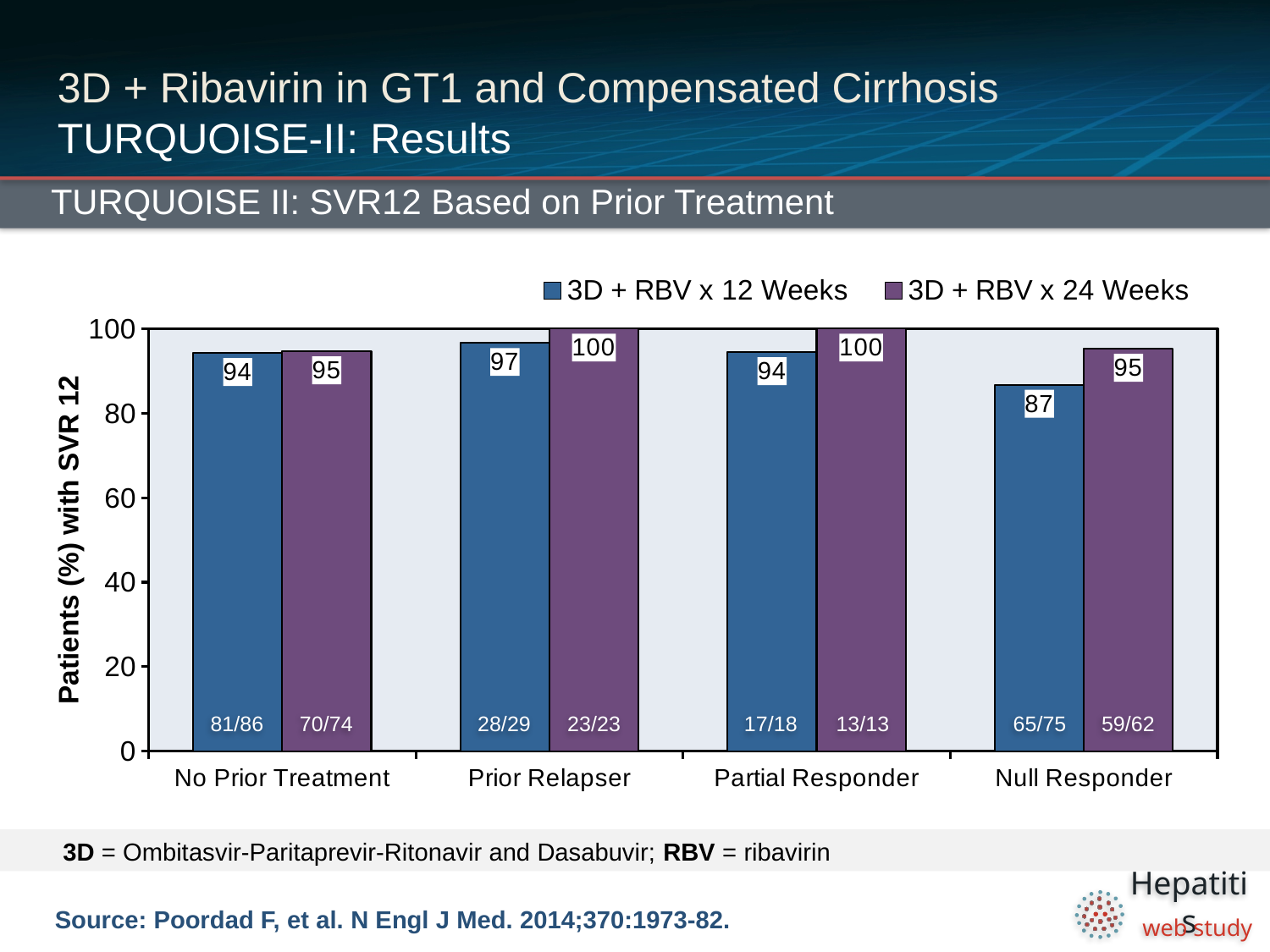
What is the SVR12 rate for the 3D + RBV x 24 Weeks group among Prior Relapsers? 100 How many patients achieved SVR12 out of the total in the 3D + RBV x 24 Weeks group among Null Responders? 59/62 How many prior treatment categories are shown on the x axis? 4 What is the difference in SVR12 rate between the 24-week and 12-week groups among Null Responders? 8 Is the SVR12 rate for the 3D + RBV x 12 Weeks group among Null Responders greater or less than 80? greater Among Partial Responders, which group has the higher SVR12 rate, 3D + RBV x 12 Weeks or 3D + RBV x 24 Weeks? 3D + RBV x 24 Weeks What is the label of the y axis? Patients (%) with SVR 12 What is the SVR12 rate for the 3D + RBV x 12 Weeks group among patients with No Prior Treatment? 94 How many series does the legend list? 2 What is the SVR12 rate for the 3D + RBV x 12 Weeks group among Null Responders? 87 Which prior treatment category has the lowest SVR12 rate for the 3D + RBV x 12 Weeks group? Null Responder What kind of chart is shown on the slide? Bar chart